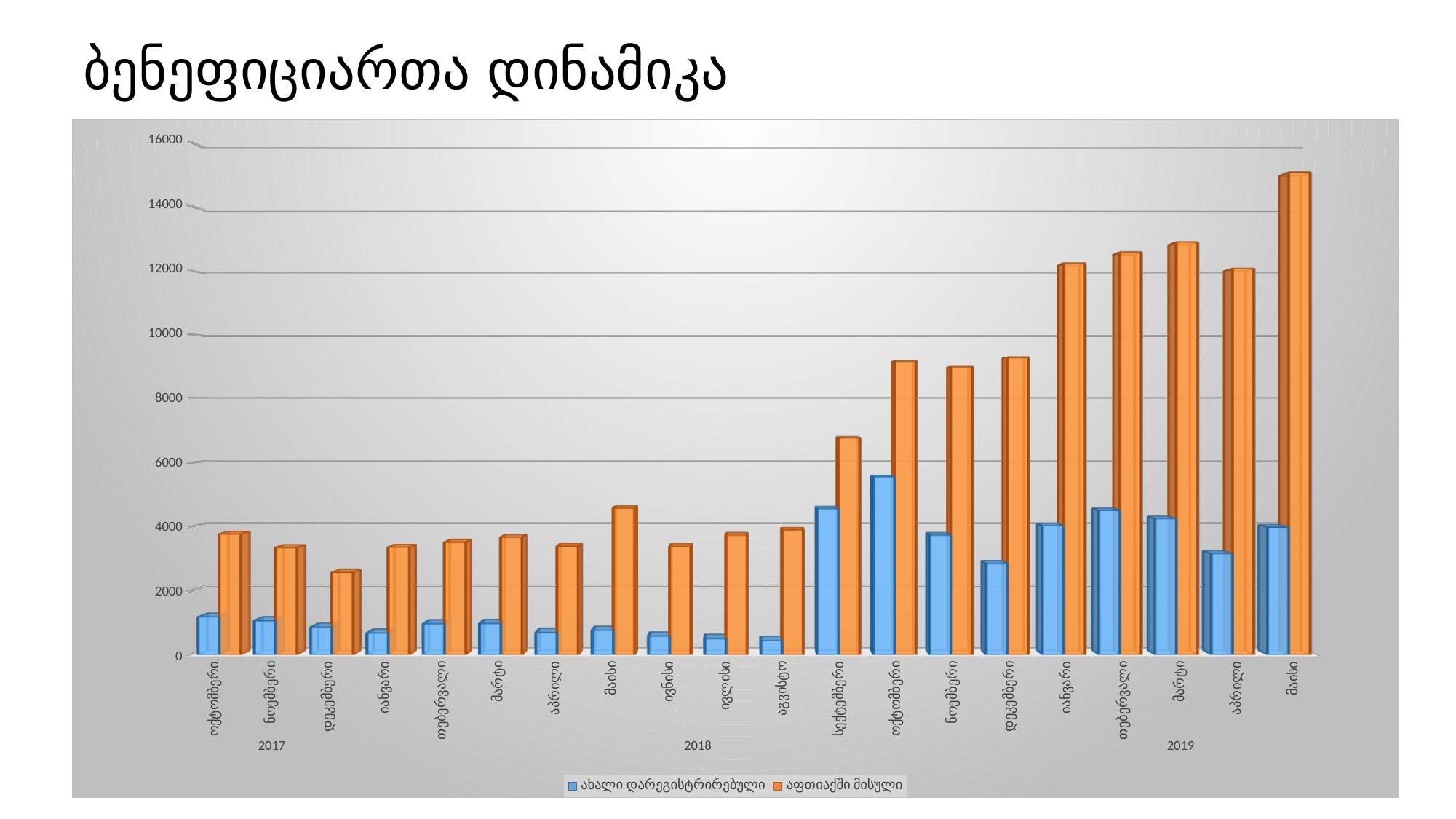
In which month is the value for "ახალი დარეგისტრირებული" highest? ოქტომბერი 2018 Is the value for "ახალი დარეგისტრირებული" in ოქტომბერი 2018 greater or less than 4000? greater What kind of chart is shown on the slide? bar chart How many month categories are plotted along the x axis? 20 In which month is the value for "აფთიაქში მისული" highest? მაისი 2019 Is the value for "აფთიაქში მისული" in დეკემბერი 2017 greater or less than 4000? less Which colour represents the series "აფთიაქში მისული" in the legend? orange Which is larger: the value for "აფთიაქში მისული" in მაისი 2019 or in აპრილი 2019? მაისი 2019 In which month is the value for "აფთიაქში მისული" lowest? დეკემბერი 2017 What is the title of the slide? ბენეფიციართა დინამიკა How many series does the legend list? 2 Is the value for "აფთიაქში მისული" in მაისი 2019 greater or less than 14000? greater